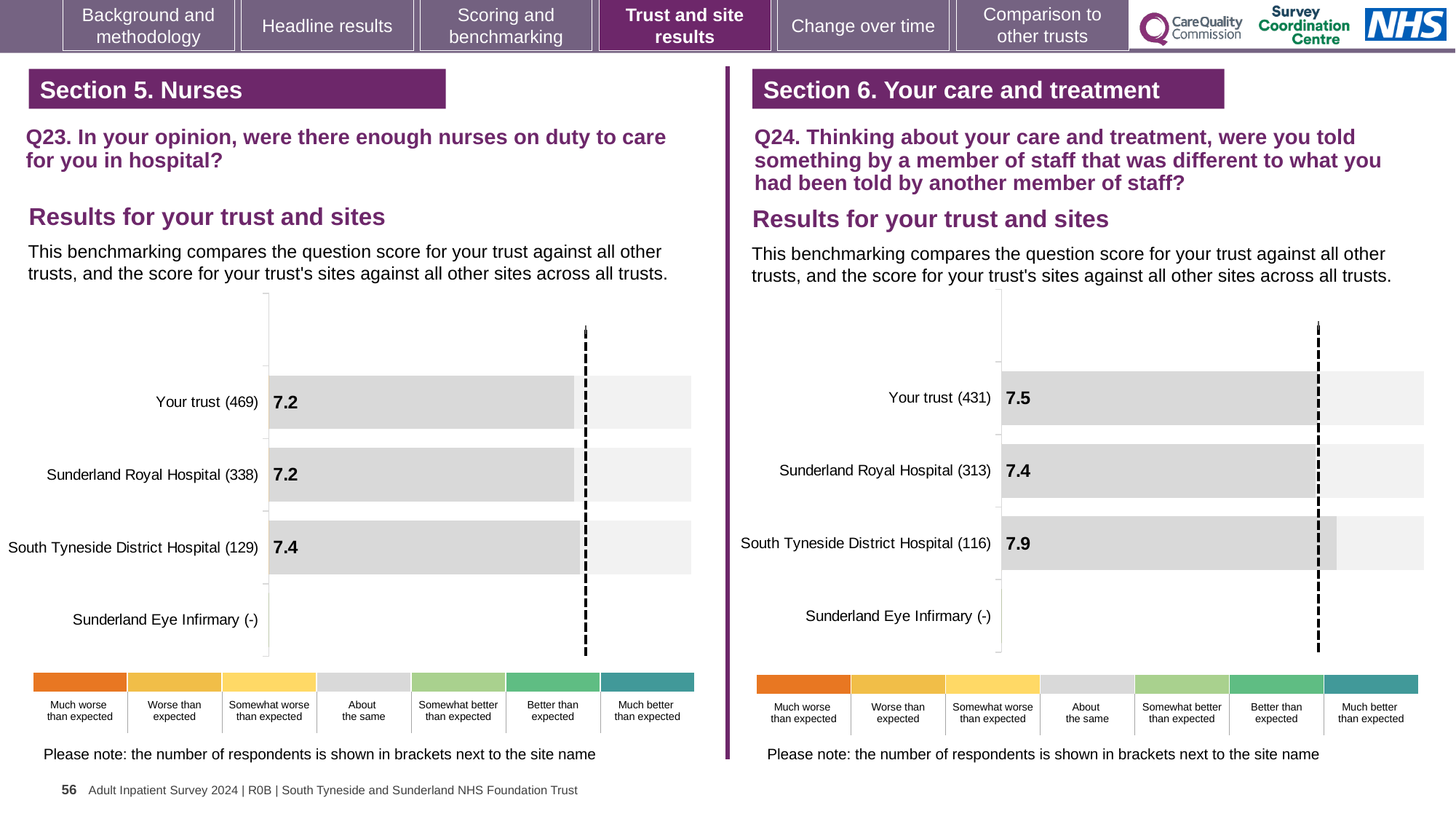
What type of chart is used on the Q23 chart (left)? Bar chart On the Q24 chart (right), what is the score for Sunderland Royal Hospital? 7.4 On the Q24 chart (right), which has the larger score: Your trust or Sunderland Royal Hospital? Your trust On the Q24 chart (right), which site has no score shown? Sunderland Eye Infirmary On the Q24 chart (right), what is the score for South Tyneside District Hospital? 7.9 On the Q24 chart (right), what is the difference between the scores for South Tyneside District Hospital and Your trust? 0.4 On the Q23 chart (left), what is the score for Your trust? 7.2 On the Q23 chart (left), what is the score for South Tyneside District Hospital? 7.4 On the Q24 chart (right), which site has the highest score? South Tyneside District Hospital On the Q23 chart (left), what is the difference between the scores for South Tyneside District Hospital and Sunderland Royal Hospital? 0.2 On the Q24 chart (right), which site has the lowest printed score? Sunderland Royal Hospital How many respondents are shown in brackets for Your trust on the Q23 chart (left)? 469